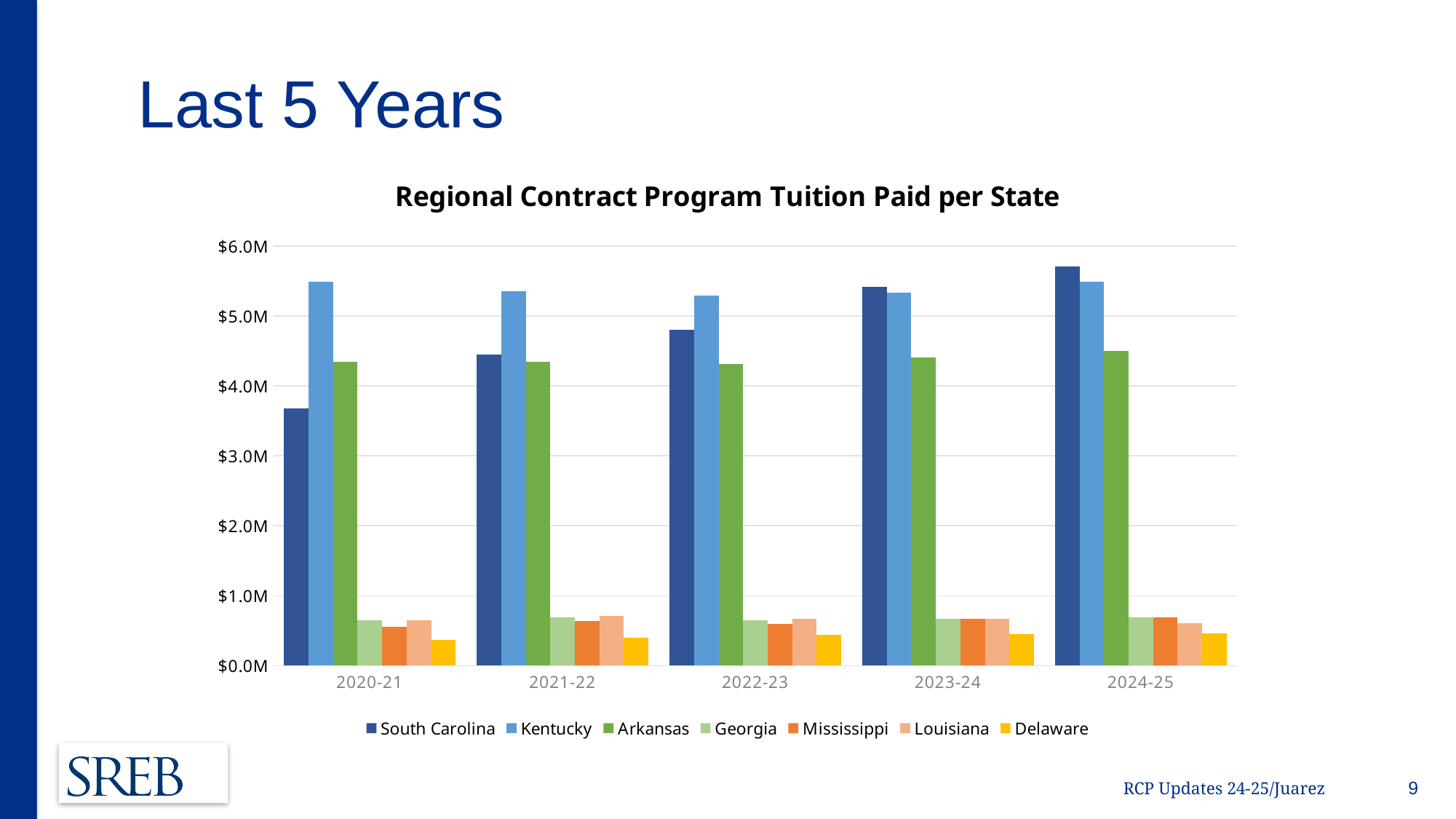
Is the value for Arkansas in 2024-25 greater or less than $4.0M? greater Is the value for Kentucky in 2020-21 greater or less than $5.0M? greater In 2024-25, which paid more tuition, South Carolina or Kentucky? South Carolina Which state has the lowest tuition paid in 2020-21? Delaware What is the title of the chart? Regional Contract Program Tuition Paid per State Which state has the highest tuition paid in 2022-23? Kentucky How many states does the legend list? 7 Is the value for South Carolina in 2020-21 greater or less than $4.0M? less In 2020-21, which paid more tuition, Kentucky or South Carolina? Kentucky How many academic years are shown on the x axis? 5 What kind of chart is shown on the slide? Bar chart Does the tuition paid by South Carolina rise or fall from 2020-21 to 2024-25? Rise